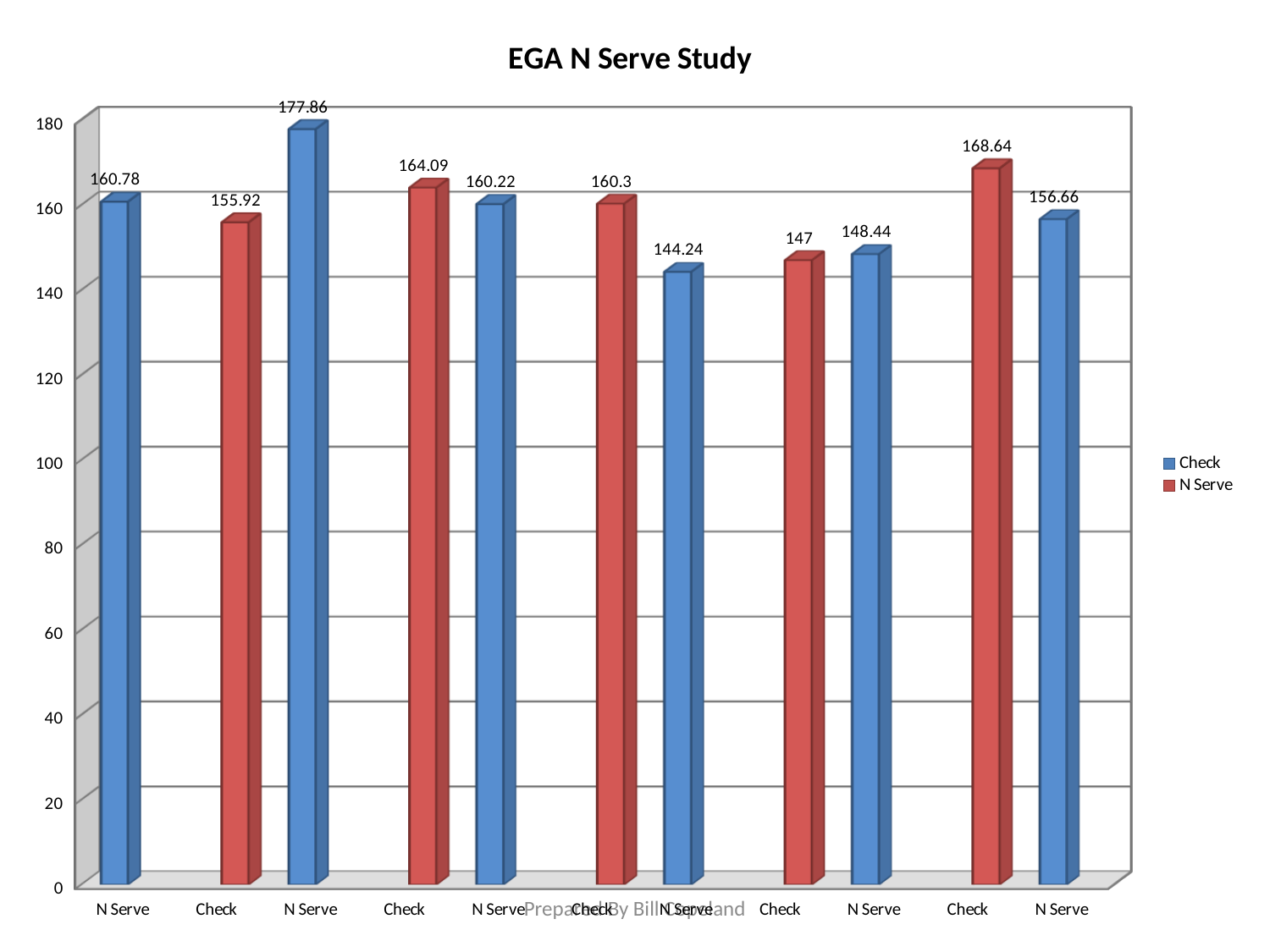
How many bars are plotted in the chart? 11 What is the title of the chart? EGA N Serve Study Is the value of the shortest bar greater or less than 140? greater What is the value of the first (leftmost) bar in the chart? 160.78 What is the value of the tallest bar in the chart? 177.86 What is the value of the tenth bar from the left, the tallest red bar? 168.64 What is the difference between the tallest bar (177.86) and the shortest bar (144.24)? 33.62 What is the value of the shortest bar in the chart? 144.24 What is the value of the last (rightmost) bar in the chart? 156.66 Which is larger, the tenth bar (168.64) or the eleventh bar (156.66)? the tenth bar (168.64) What kind of chart is shown on the slide? bar chart How many series does the legend list? 2